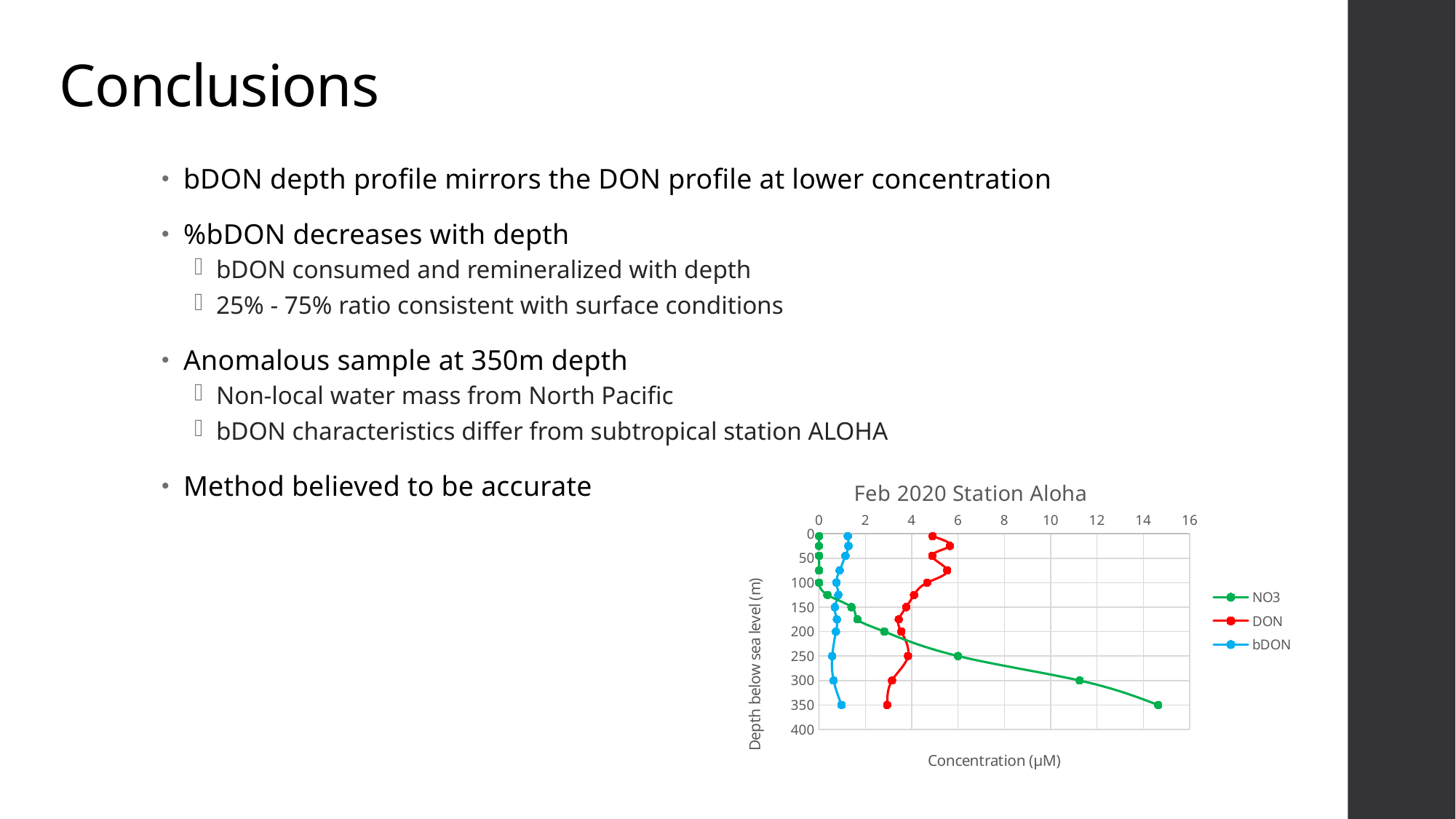
Does the NO3 concentration rise or fall as depth increases from 200 m to 350 m? rise What is the label of the chart's x axis? Concentration (µM) Is the bDON concentration at 350 m depth greater or less than 2? less At 0 m depth, which series has the larger concentration, DON or NO3? DON At 350 m depth, which series has the larger concentration, NO3 or DON? NO3 Is the NO3 concentration at 300 m depth greater or less than 10? greater Which series reaches the highest concentration on the chart? NO3 What kind of chart is shown on the slide? line chart What is the title of the chart on the slide? Feb 2020 Station Aloha Is the DON concentration at 25 m depth greater or less than 4? greater How many series does the chart's legend list? 3